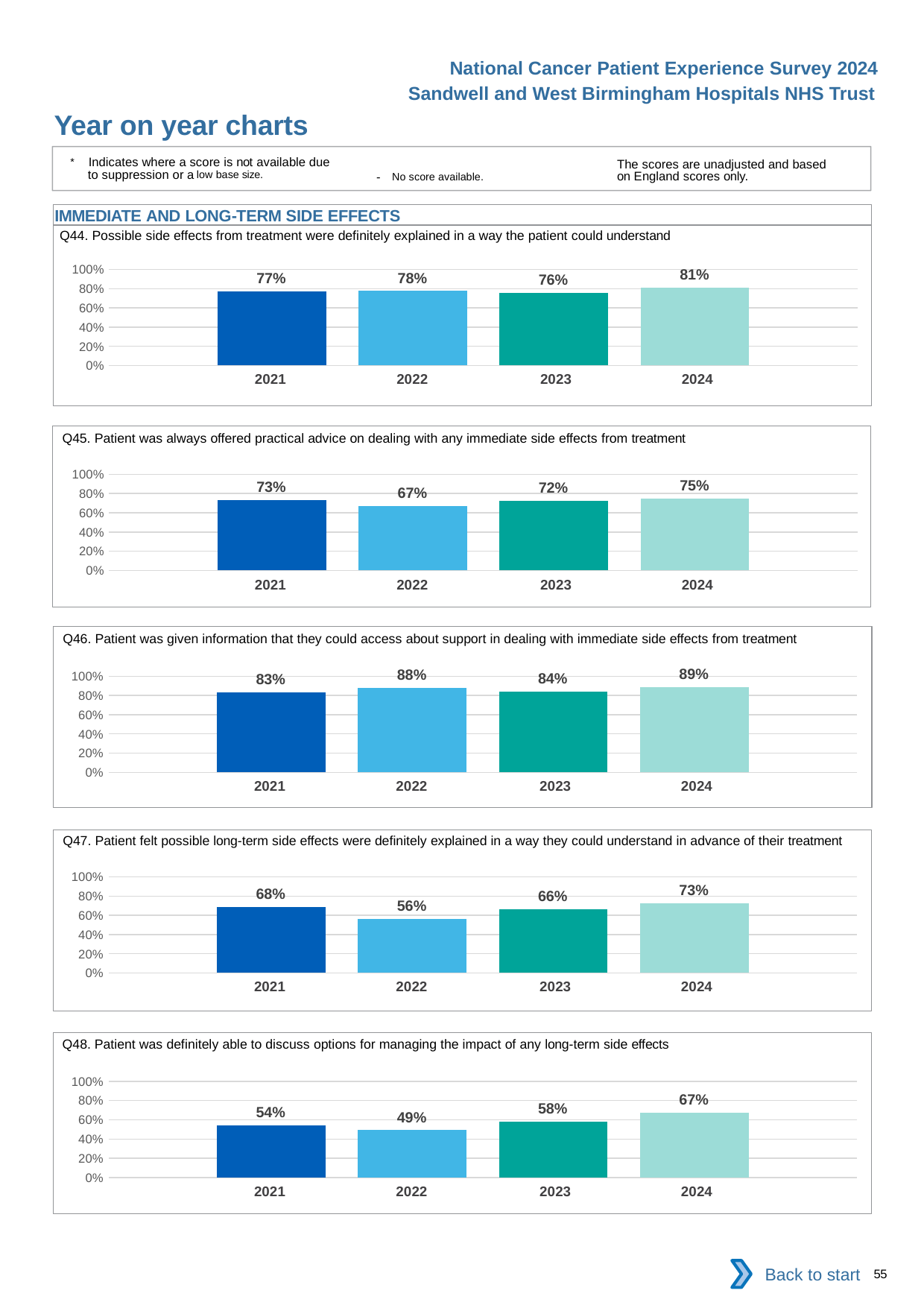
In the Q47 chart, which year has the highest value? 2024 In the Q48 chart, what is the value for 2022? 49% In the Q46 chart, what is the value for 2022? 88% In the Q45 chart, which year has the lowest value? 2022 In the Q44 chart, what is the value for 2024? 81% In the Q48 chart, what is the difference between the 2023 and 2022 values? 9% How many years are shown in the Q45 chart? 4 In the Q46 chart, what is the difference between the 2024 and 2021 values? 6% In the Q47 chart, is the value for 2021 or 2023 larger? 2021 In the Q48 chart, is the value for 2024 greater or less than 60%? greater What kind of chart is the Q44 chart? bar chart How many charts are shown on the slide? 5